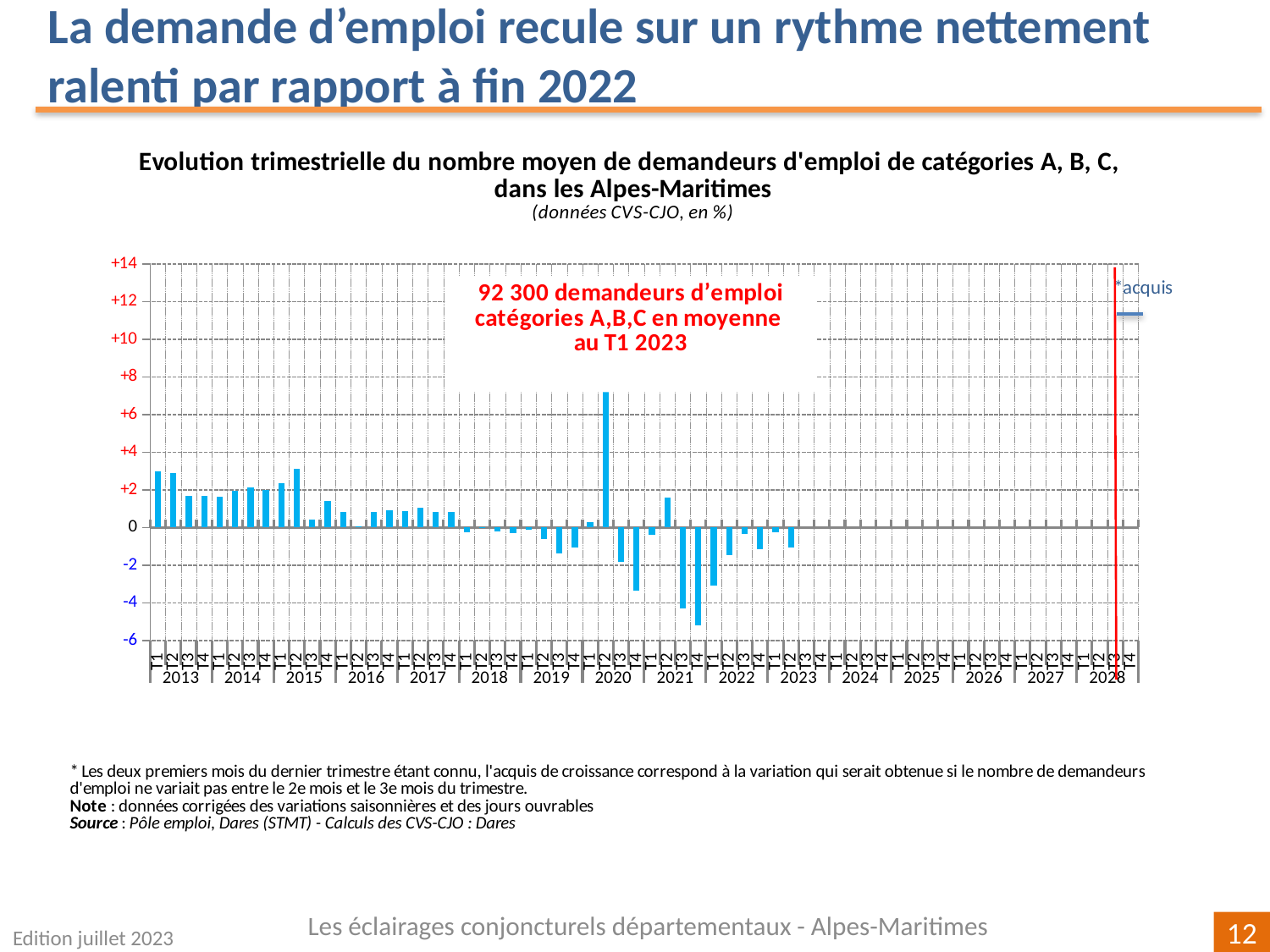
What kind of chart is shown on the slide? bar chart Which is larger, the value for T1 2013 or the value for T1 2016? T1 2013 Which is larger, the value for T3 2020 or the value for T2 2020? T2 2020 Is the value for T1 2013 greater or less than +2? greater In what unit are the chart's data expressed, according to the subtitle? en % Is the value for T4 2021 greater or less than -4? less Is the value for T1 2016 greater or less than +2? less According to the text box on the chart, how many demandeurs d'emploi catégories A,B,C were there on average in T1 2023? 92 300 Which quarter has the highest value in the chart? T2 2020 Which quarter has the lowest value in the chart? T4 2021